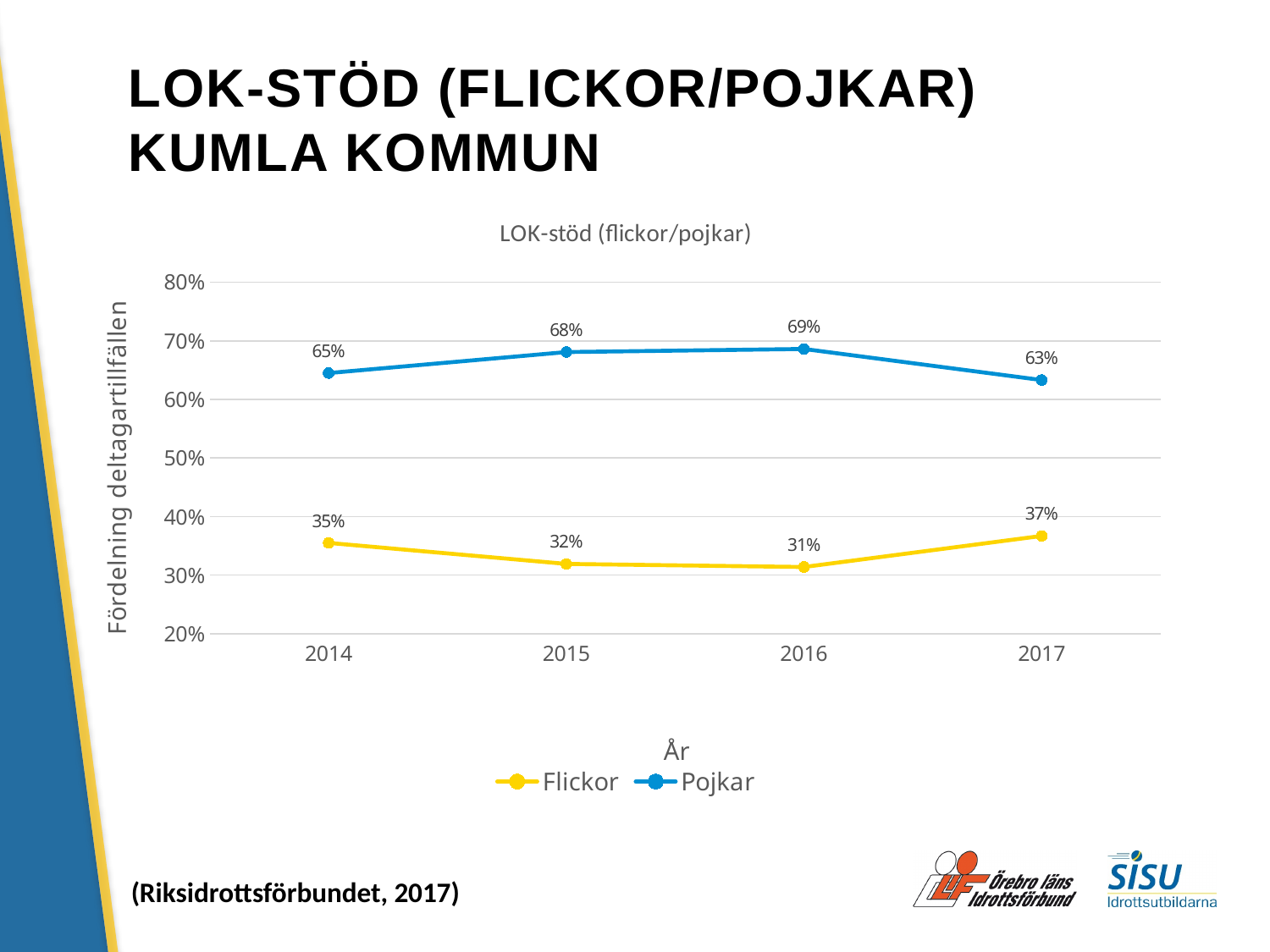
Is the value for Pojkar in 2017 greater or less than 60%? greater In which year is the Pojkar value highest? 2016 What is the difference between the Pojkar and Flickor values in 2014? 30 percentage points What is the value for Flickor in 2017? 37% In which year is the Flickor value lowest? 2016 How many series does the legend list? 2 What is the value for Flickor in 2015? 32% Which is larger in 2017, the Flickor value or the Pojkar value? Pojkar What is the title of the chart? LOK-stöd (flickor/pojkar) How many years are shown on the x axis? 4 What kind of chart is shown? Line chart What is the value for Pojkar in 2016? 69%